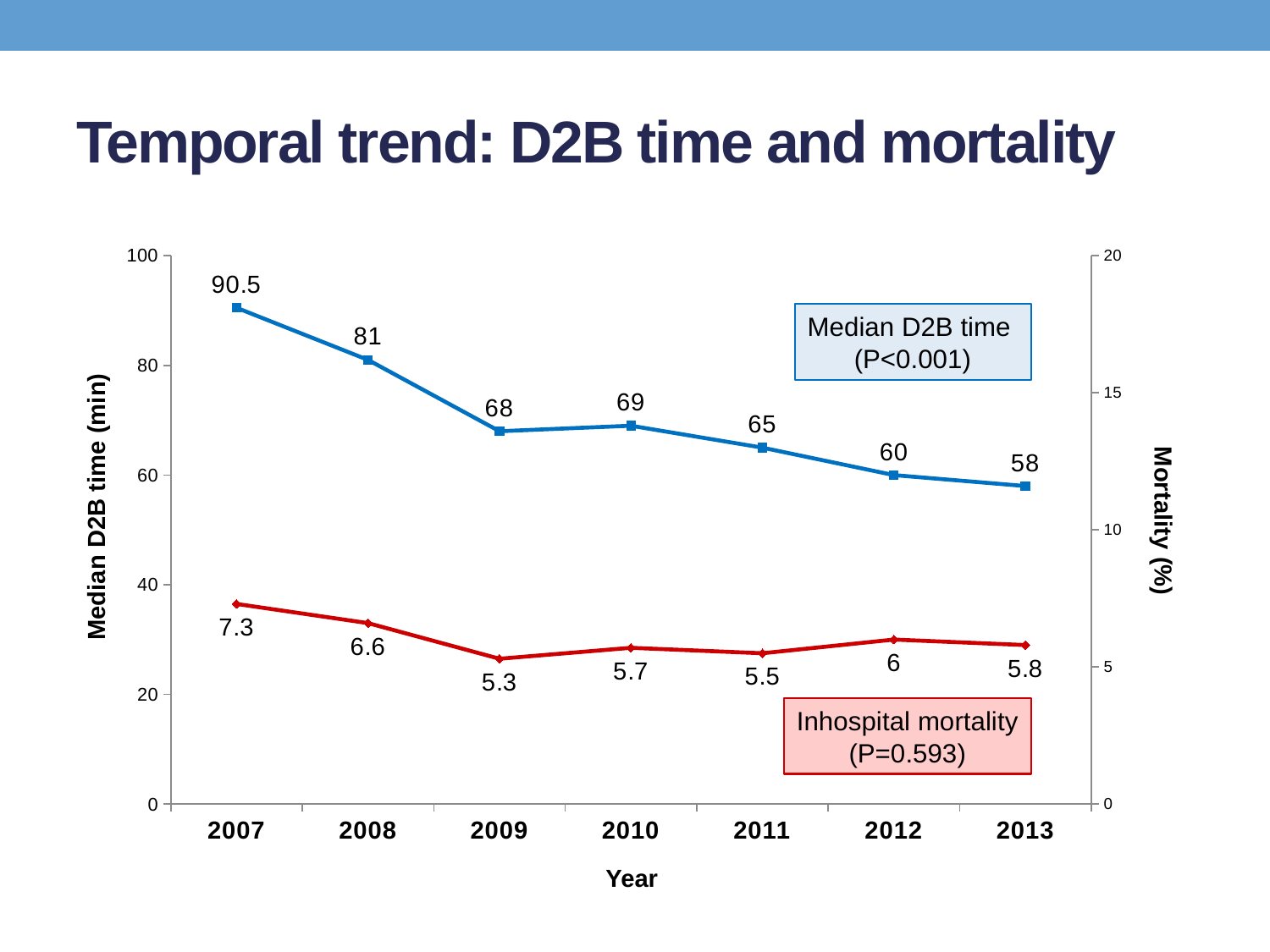
What is the median D2B time in 2007? 90.5 Does the median D2B time rise or fall from 2007 to 2013? Fall How many data series are plotted on the chart? 2 What type of chart is shown on the slide? Line chart What is the difference in median D2B time between 2007 and 2013? 32.5 What is the title of the chart on the slide? Temporal trend: D2B time and mortality Which year has the lowest inhospital mortality? 2009 Which year has the highest median D2B time? 2007 What is the median D2B time in 2013? 58 What is the inhospital mortality in 2009? 5.3 Which year has the higher median D2B time, 2009 or 2010? 2010 How many years are shown on the x axis? 7